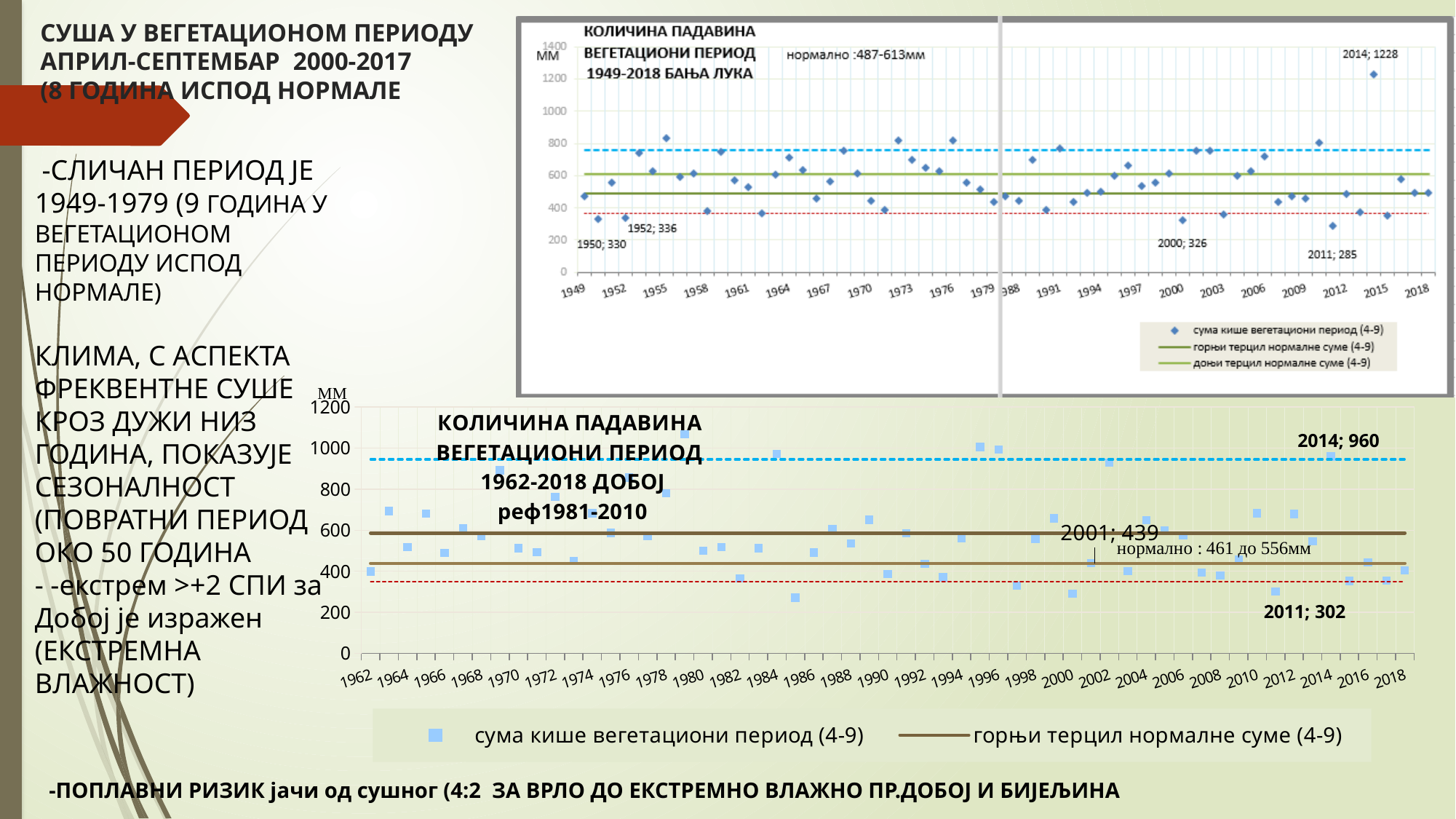
In the top-right chart (Бања Лука 1949-2018), what is the labelled precipitation value for 2014? 1228 In the top-right chart (Бања Лука 1949-2018), what is the labelled value for 2011? 285 In the bottom chart (Добој 1962-2018), what is the difference between the labelled values for 2014 and 2011? 658 In the top-right chart (Бања Лука 1949-2018), what is the difference between the labelled values for 1952 and 1950? 6 In the bottom chart (Добој 1962-2018), what is the labelled value for 2001? 439 In the top-right chart (Бања Лука 1949-2018), what is the labelled value for 1950? 330 In the top-right chart (Бања Лука 1949-2018), which year has the highest precipitation sum? 2014 In the bottom chart (Добој 1962-2018), is the value for 1979 greater or less than 1000? greater In the top-right chart (Бања Лука 1949-2018), is the value for 1949 greater or less than 600? less What kind of chart is the bottom chart (Добој 1962-2018)? scatter chart In the top-right chart (Бања Лука 1949-2018), how many entries does the legend list? 3 In the bottom chart (Добој 1962-2018), what is the labelled value for 2014? 960